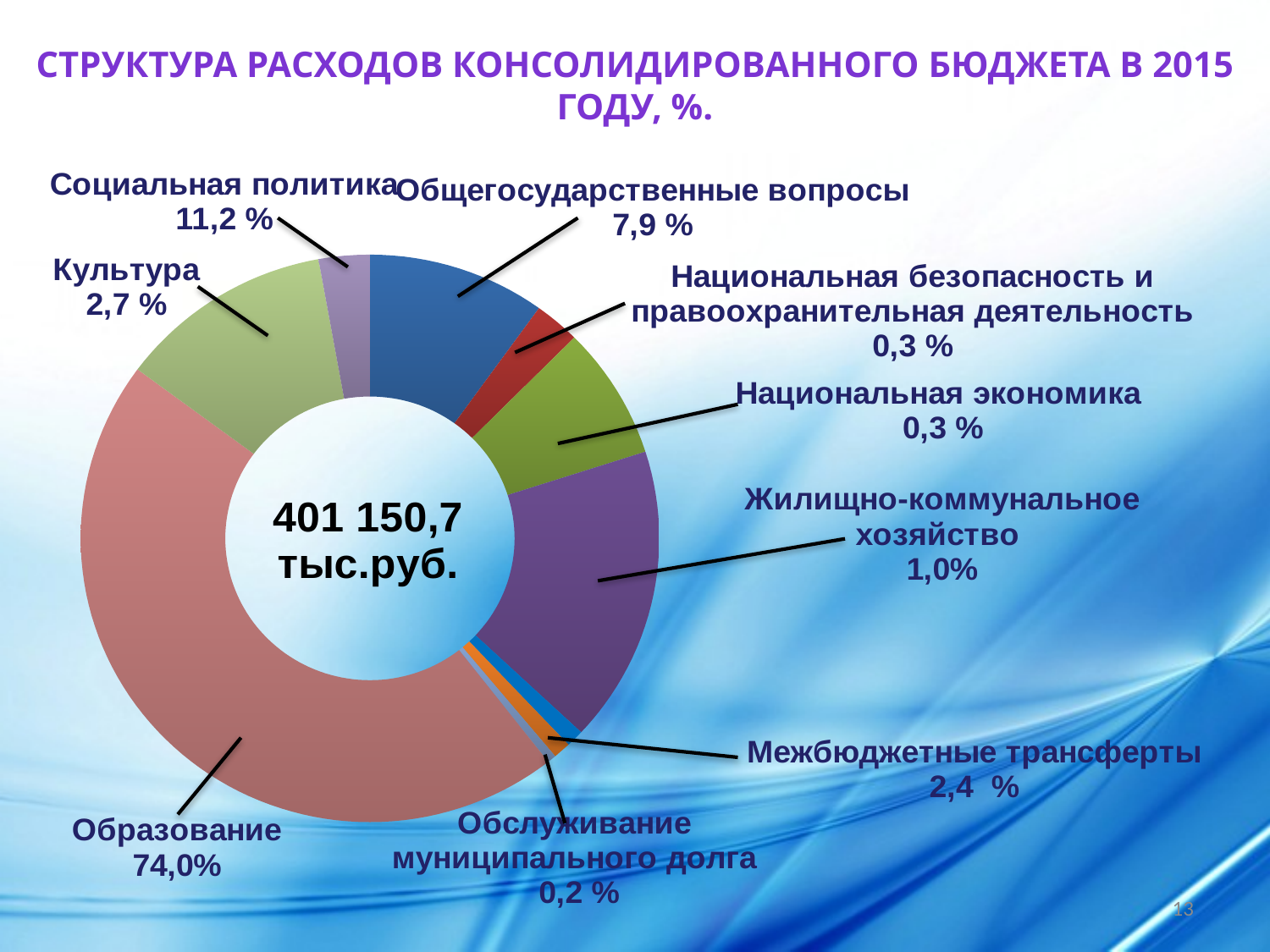
What is the difference in percentage points between Социальная политика and Общегосударственные вопросы? 3,3 What percentage is shown for Общегосударственные вопросы? 7,9 % What share of expenditures does Образование account for? 74,0% What type of chart is used on the slide? Doughnut chart What share is shown for Жилищно-коммунальное хозяйство? 1,0% Which is larger, the share for Культура or the share for Межбюджетные трансферты? Культура What is the value for Межбюджетные трансферты? 2,4 % What total amount is printed in the centre of the chart? 401 150,7 тыс.руб. How many expenditure categories are shown in the chart? 9 What is the value shown for Социальная политика? 11,2 % Which category has the largest share of the budget expenditures? Образование Which category has the smallest share according to the labels? Обслуживание муниципального долга